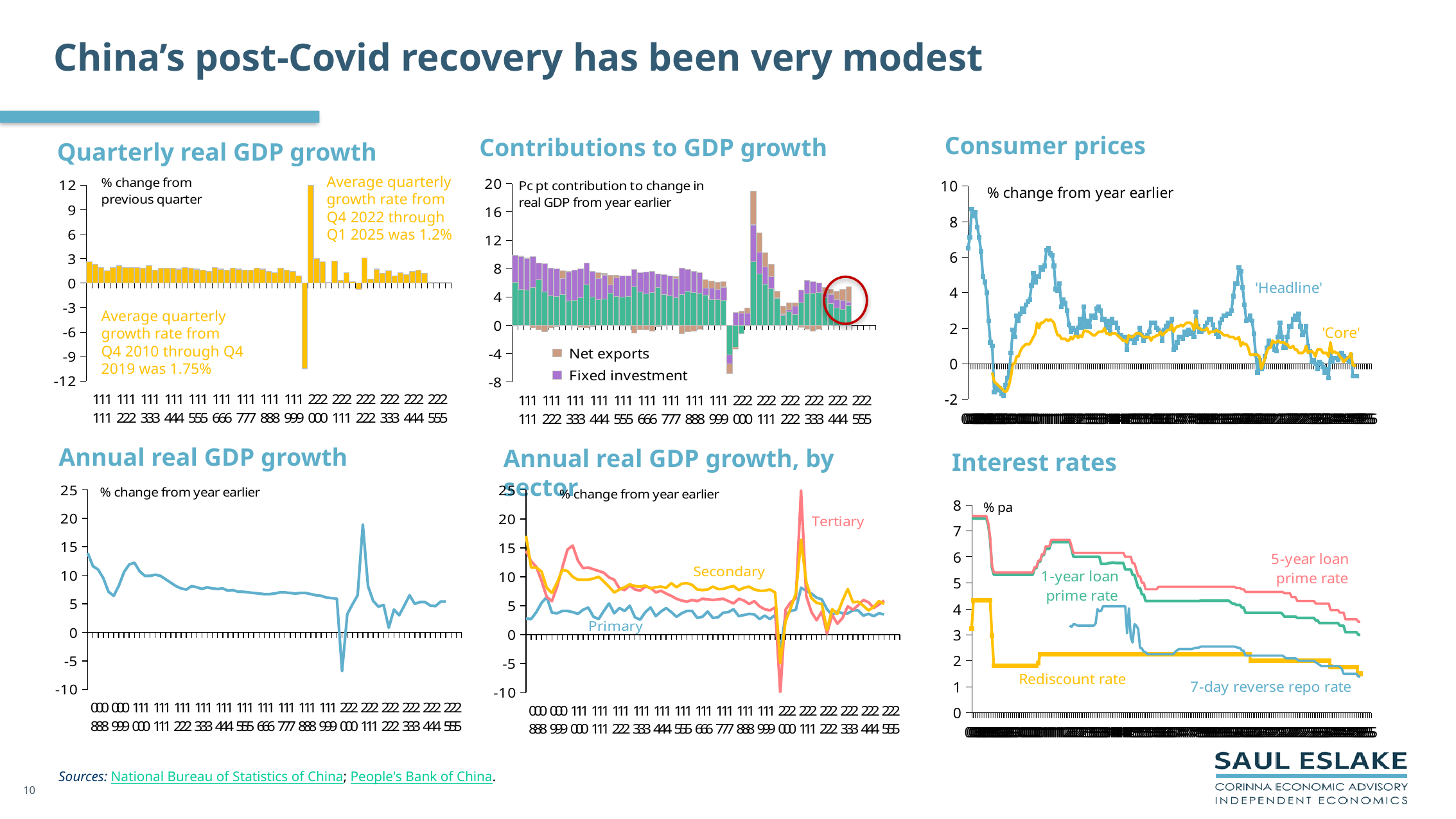
How many labelled series are shown on the 'Interest rates' chart? 4 What kind of chart is the 'Consumer prices' chart? line chart On the 'Interest rates' chart, is the Rediscount rate at the right-hand end greater or less than 2? less On the 'Annual real GDP growth' chart, is the lowest value greater or less than -5? less How many labelled series are shown on the 'Annual real GDP growth, by sector' chart? 3 On the 'Annual real GDP growth, by sector' chart, is the peak of the Tertiary series greater or less than 20? greater How many series does the legend of the 'Contributions to GDP growth' chart list? 2 On the 'Quarterly real GDP growth' chart, what was the average quarterly growth rate from Q4 2010 through Q4 2019? 1.75% On the 'Interest rates' chart, which is higher at the right-hand end: the 5-year loan prime rate or the 1-year loan prime rate? 5-year loan prime rate What kind of chart is the 'Quarterly real GDP growth' chart? bar chart On the 'Quarterly real GDP growth' chart, what was the average quarterly growth rate from Q4 2022 through Q1 2025? 1.2%